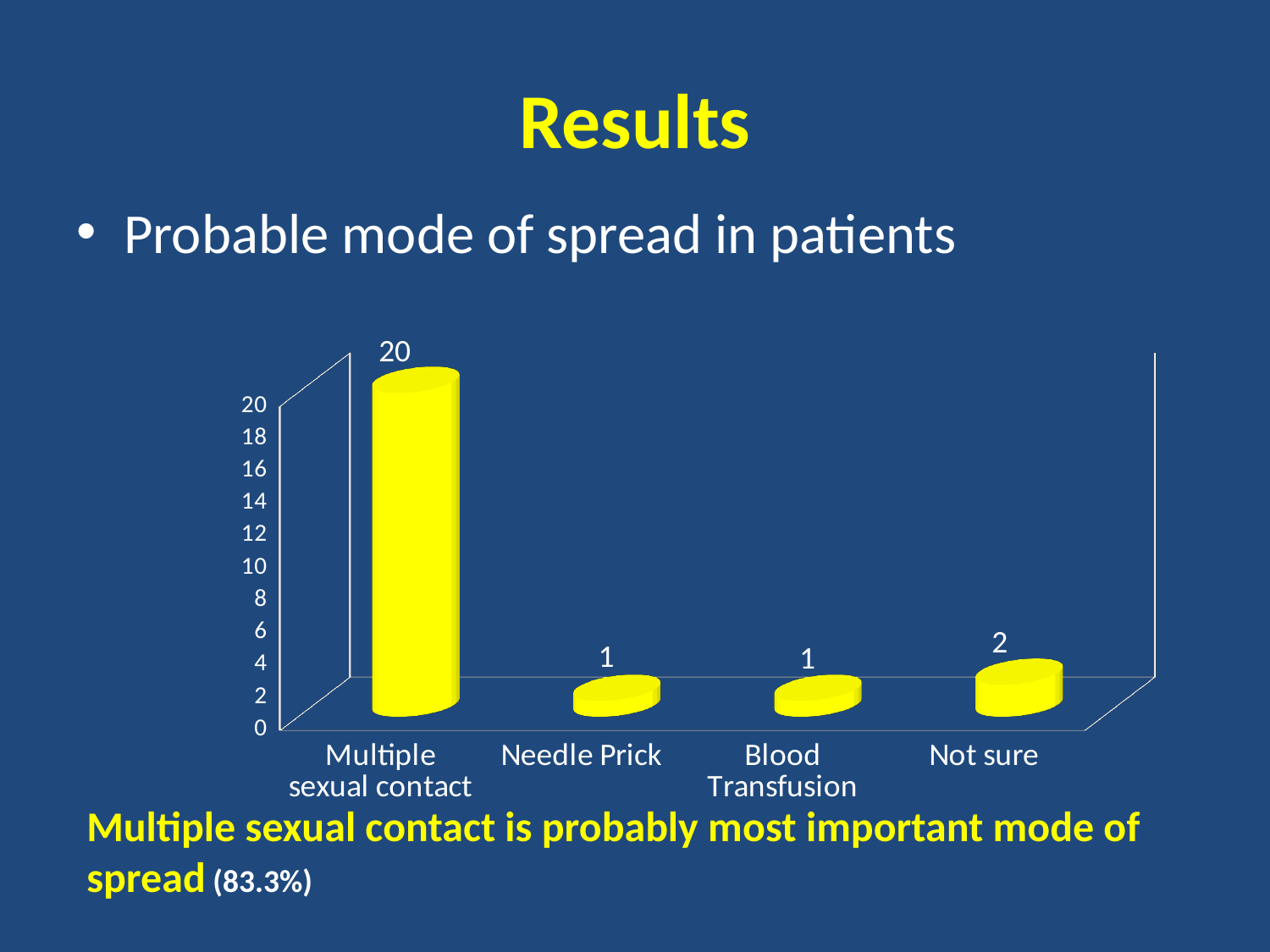
What is the value for Needle Prick? 1 What colour are the bars in the chart? yellow What kind of chart is shown on the slide? bar chart Is the value for Multiple sexual contact greater or less than 10? greater What is the difference between the values for Multiple sexual contact and Not sure? 18 What is the total of all four plotted values? 24 Which category has the highest value? Multiple sexual contact What is the value for Not sure? 2 How many categories are shown on the x axis? 4 What is the value for Blood Transfusion? 1 What is the value for Multiple sexual contact? 20 Which is larger, the value for Not sure or the value for Needle Prick? Not sure